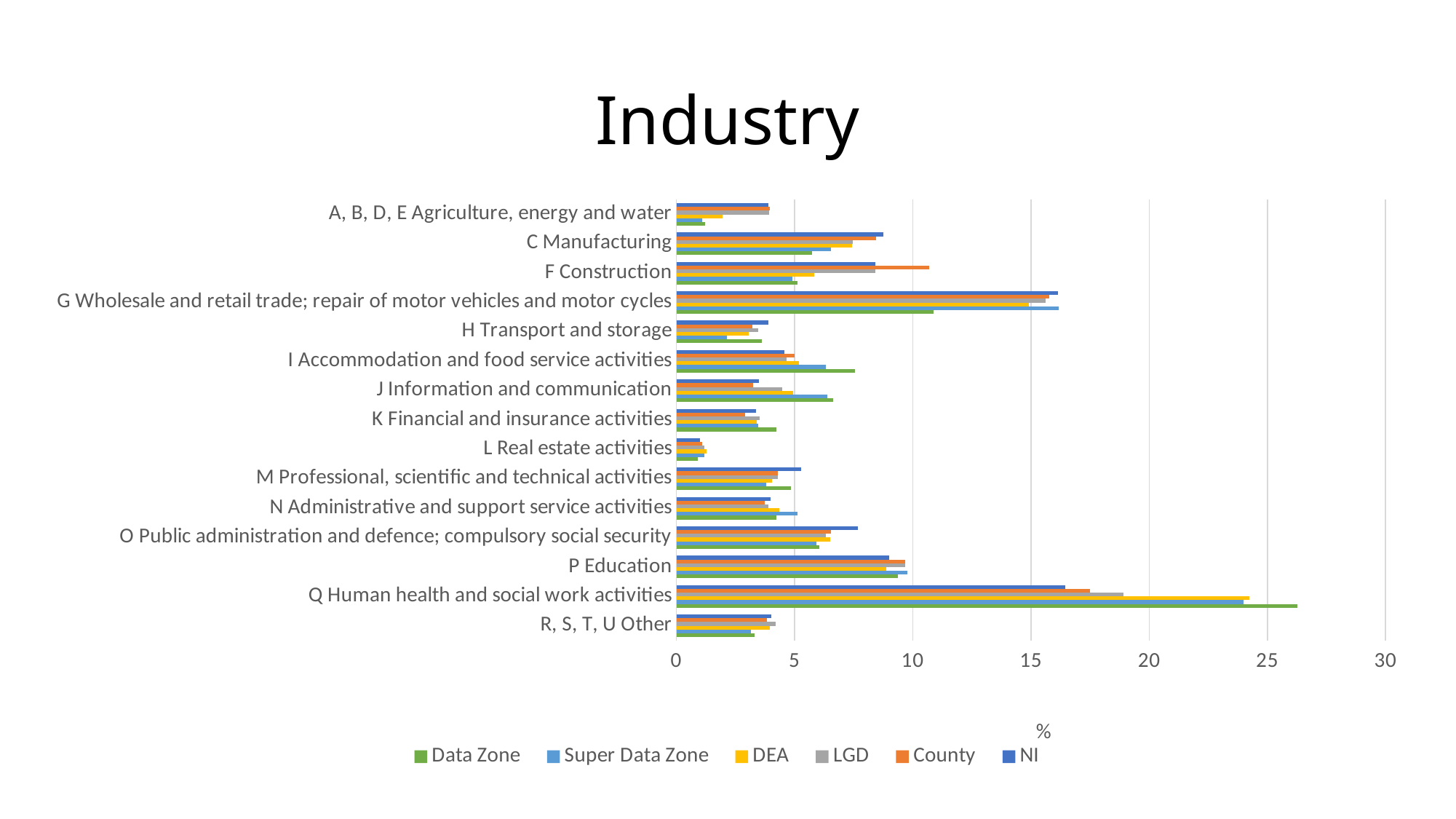
What is the title of the chart? Industry For F Construction, which is larger: the County value or the NI value? County What unit is shown on the horizontal axis label? % Is the Data Zone value for Q Human health and social work activities greater or less than 25? greater How many industry categories are plotted on the chart? 15 What kind of chart is shown on the slide? bar chart Is the Data Zone value for A, B, D, E Agriculture, energy and water greater or less than 5? less Is the NI value for G Wholesale and retail trade; repair of motor vehicles and motor cycles greater or less than 15? greater Which category has the highest County value? Q Human health and social work activities Which category has the highest Data Zone value? Q Human health and social work activities How many series does the legend list? 6